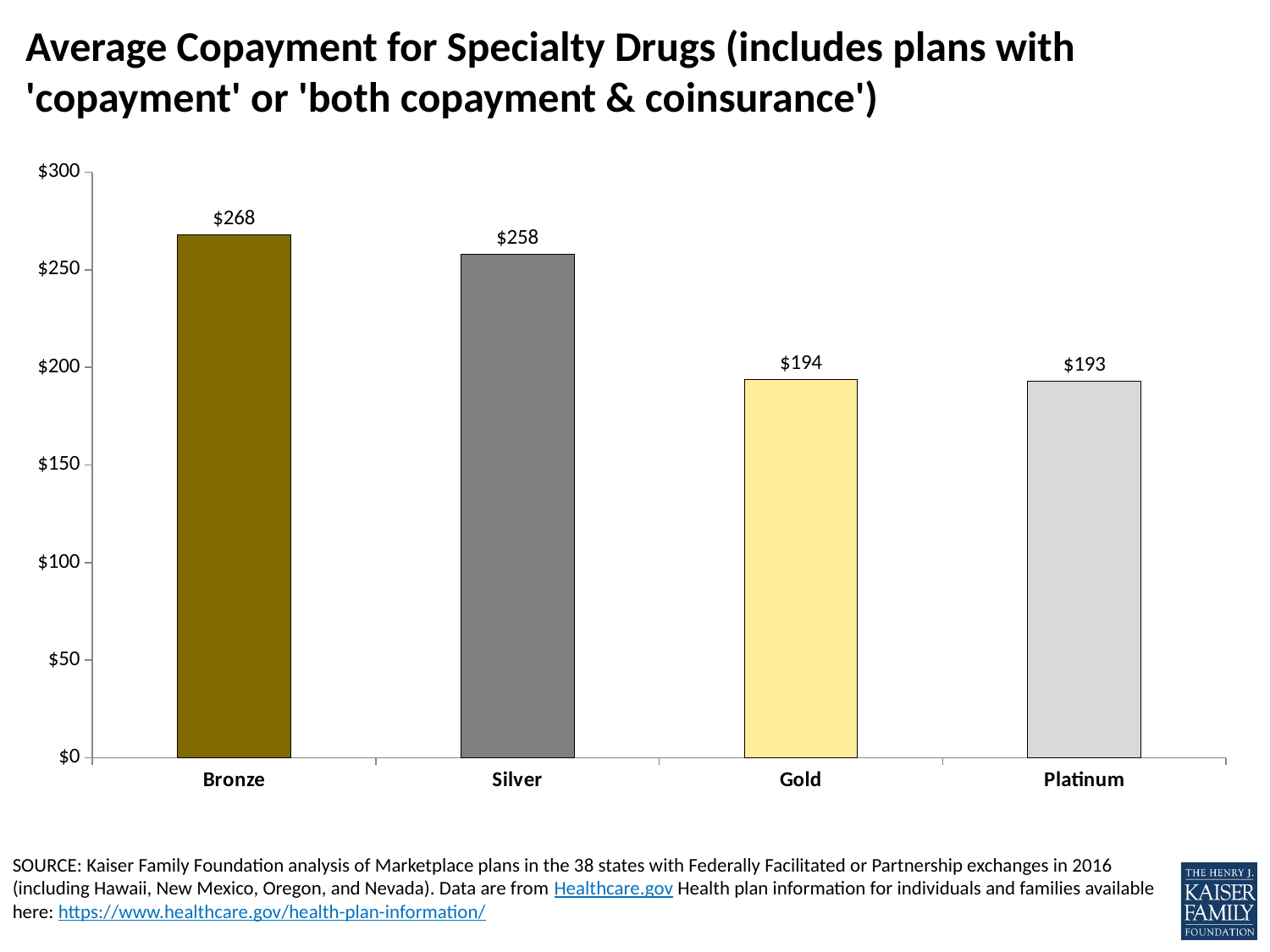
What is the average copayment for specialty drugs for Silver plans? $258 What is the difference between the average copayment for Bronze and Silver plans? $10 What is the average copayment for specialty drugs for Bronze plans? $268 What is the average copayment for specialty drugs for Platinum plans? $193 Which plan type has the highest average copayment for specialty drugs? Bronze What is the difference between the average copayment for Silver and Gold plans? $64 What is the average copayment for specialty drugs for Gold plans? $194 How many plan types are shown in the chart? 4 Which plan type has the lowest average copayment for specialty drugs? Platinum What kind of chart is shown on the slide? Bar chart Which has a larger average copayment, Silver or Gold? Silver Is the average copayment for Bronze plans greater or less than $250? greater